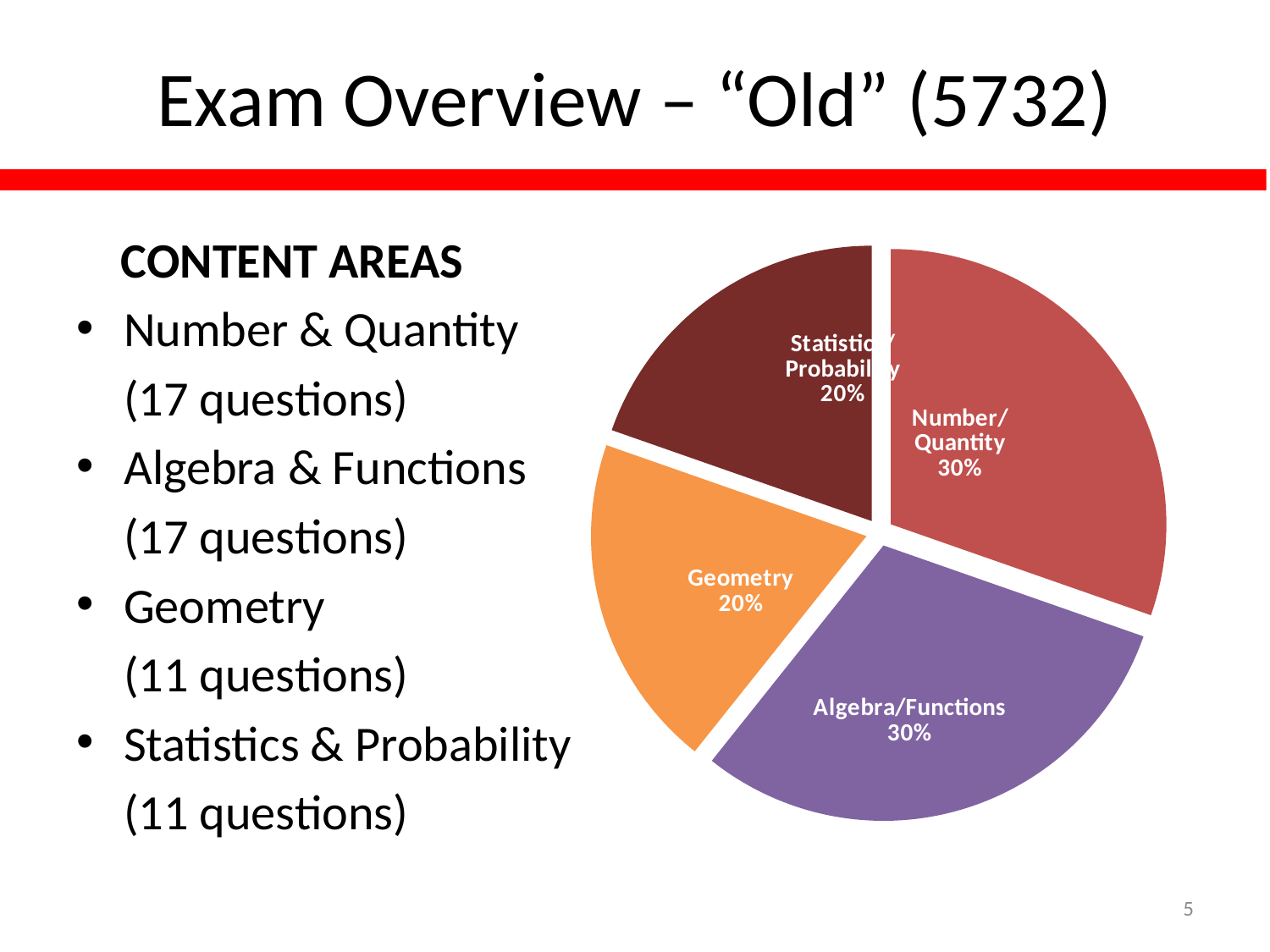
Do the Number/Quantity and Algebra/Functions slices have the same percentage? Yes Which slice is larger in the pie chart, Number/Quantity or Geometry? Number/Quantity Which slice is larger in the pie chart, Statistics/Probability or Algebra/Functions? Algebra/Functions What percentage is shown for the Algebra/Functions slice of the pie chart? 30% What is the difference in percentage points between the Algebra/Functions slice and the Geometry slice? 10 What kind of chart is shown on the slide? Pie chart What percentage is shown for the Number/Quantity slice of the pie chart? 30% What colour is the Algebra/Functions slice in the pie chart? Purple What percentage is shown for the Statistics/Probability slice of the pie chart? 20% What share of the pie chart does Geometry represent? 20% What colour is the Geometry slice in the pie chart? Orange How many slices does the pie chart have? 4